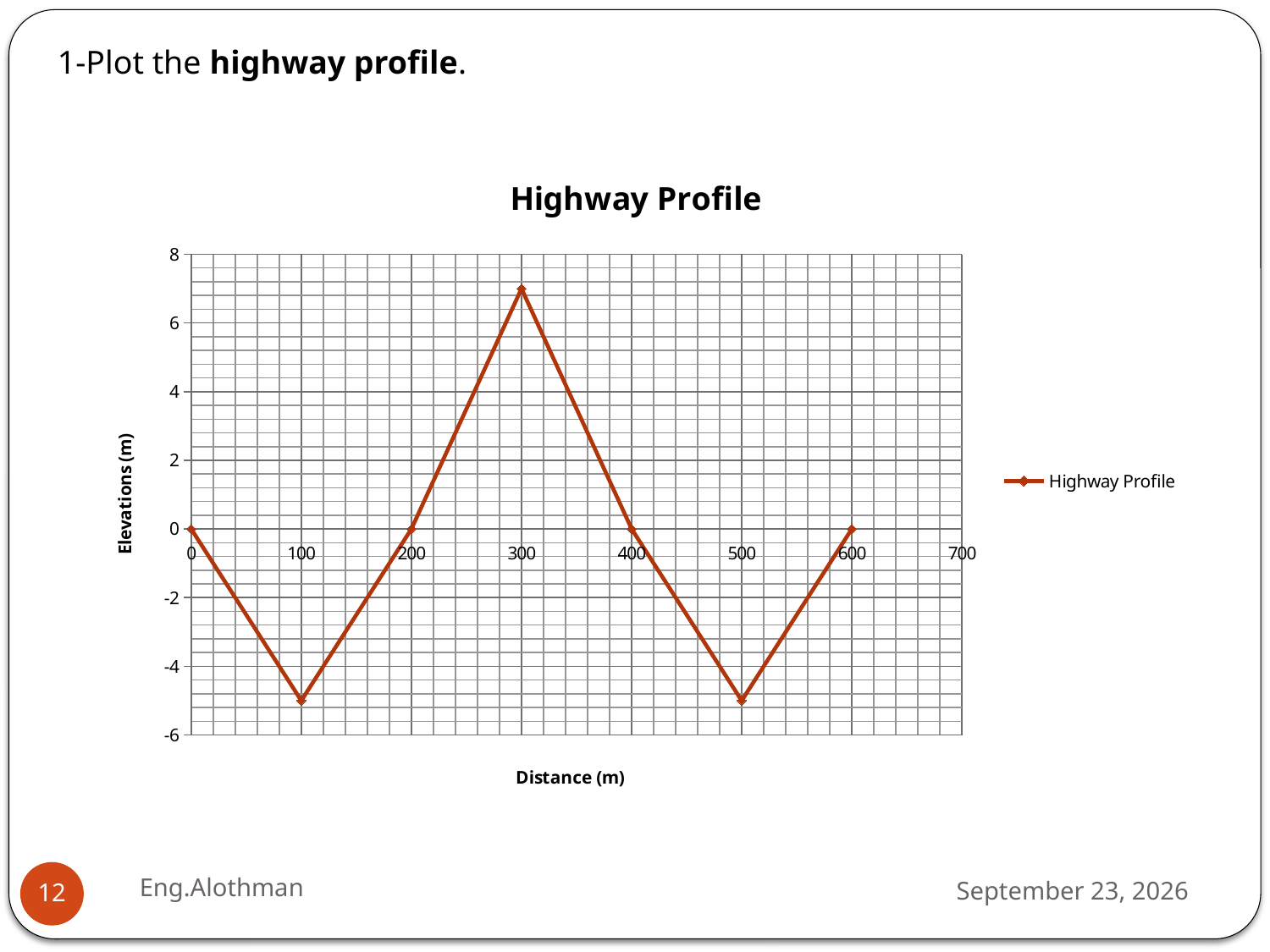
Is the elevation at 100 m greater or less than -4? less What type of chart is shown on the slide? line chart What is the label of the x axis? Distance (m) Is the elevation at 300 m greater or less than 6? greater Does the elevation rise or fall between 200 m and 300 m? rise How many data points are plotted on the Highway Profile line? 7 What is the elevation at a distance of 200 m? 0 At which distance does the highway profile reach its highest elevation? 300 What is the title of the chart? Highway Profile How many series does the legend list? 1 What is the elevation at a distance of 600 m? 0 What is the elevation at a distance of 0 m? 0